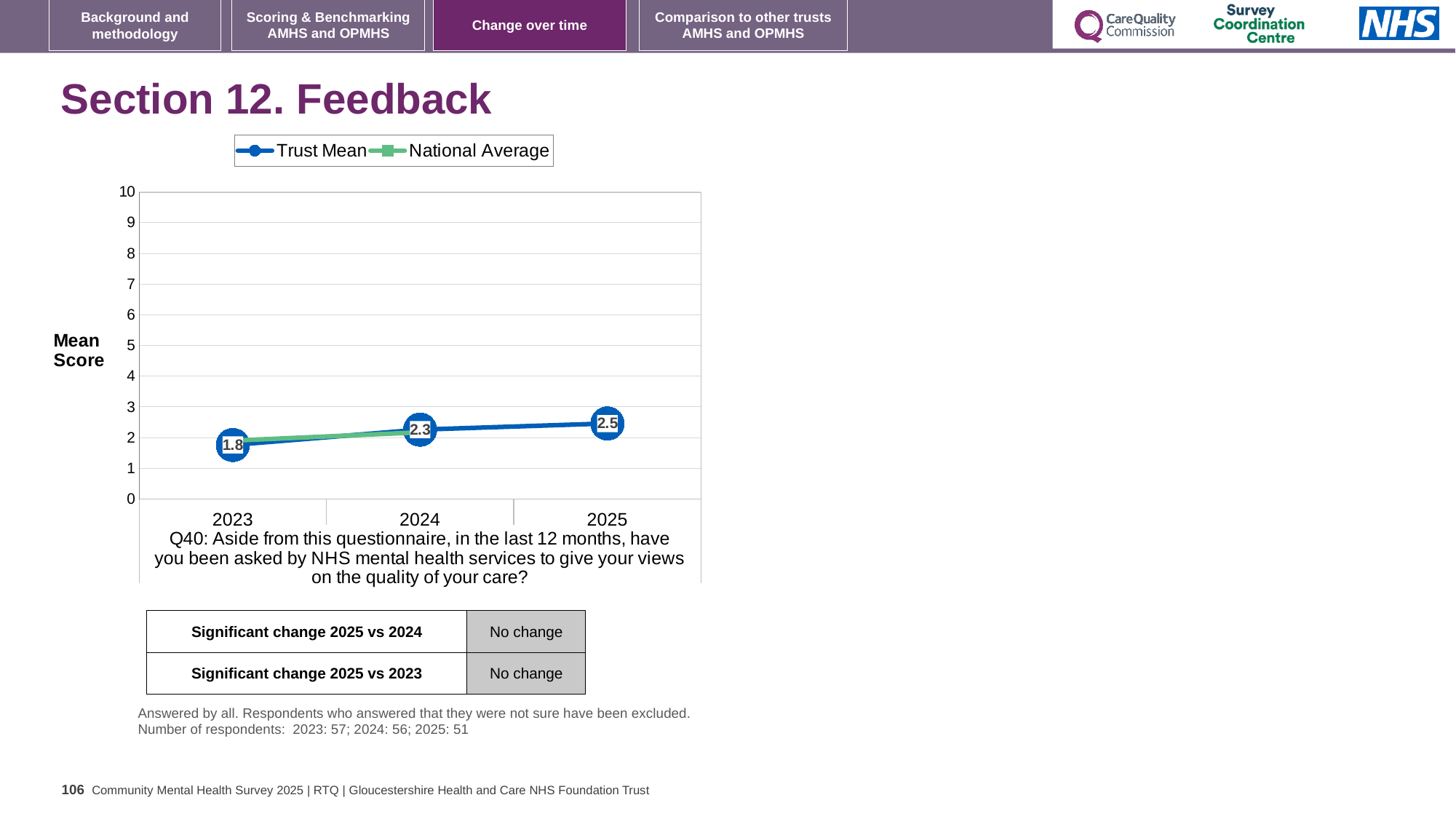
What is the difference between the Trust Mean in 2025 and in 2023? 0.7 How many years are plotted on the x axis? 3 In which year is the Trust Mean lowest? 2023 In which year is the Trust Mean highest? 2025 What is the Trust Mean value for 2023? 1.8 What is the Trust Mean value for 2024? 2.3 What is the Trust Mean value for 2025? 2.5 How many series does the legend list? 2 What kind of chart is shown on the slide? line chart Does the Trust Mean rise or fall from 2023 to 2025? rise Which is larger, the Trust Mean for 2024 or for 2023? 2024 Is the Trust Mean value for 2025 greater or less than 5? less